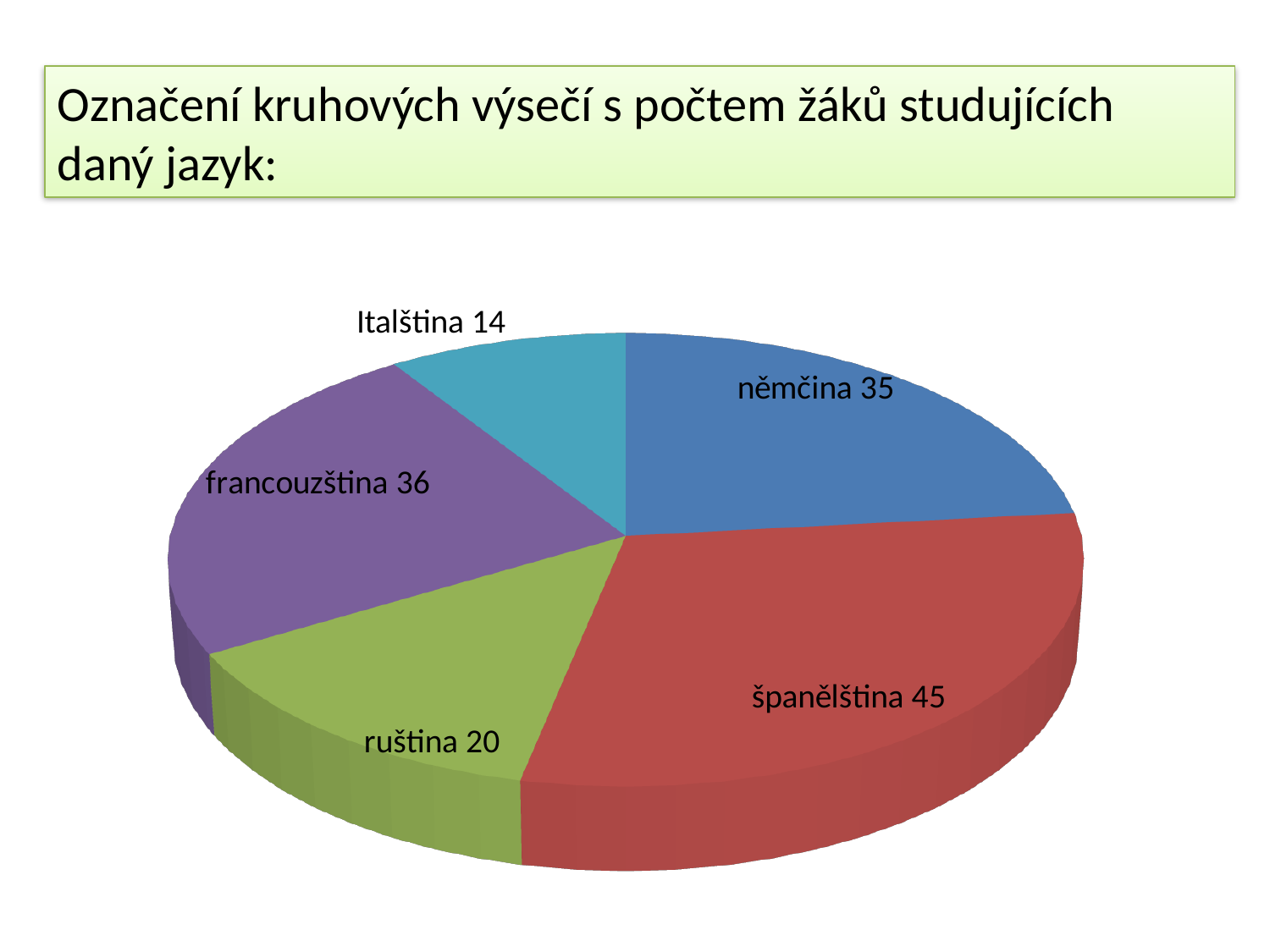
What kind of chart is shown on the slide? pie chart How many students study španělština according to the pie chart? 45 What value is shown for francouzština on the pie chart? 36 What value is shown for Italština on the pie chart? 14 What is the difference between the values for španělština and Italština? 31 What is the difference between the values for francouzština and němčina? 1 How many slices does the pie chart have? 5 Which language has the smallest slice of the pie chart? Italština Which language has the largest slice of the pie chart? španělština Which has a larger value, ruština or němčina? němčina What share of the pie does španělština represent? 30% What is the total of all values shown on the pie chart? 150